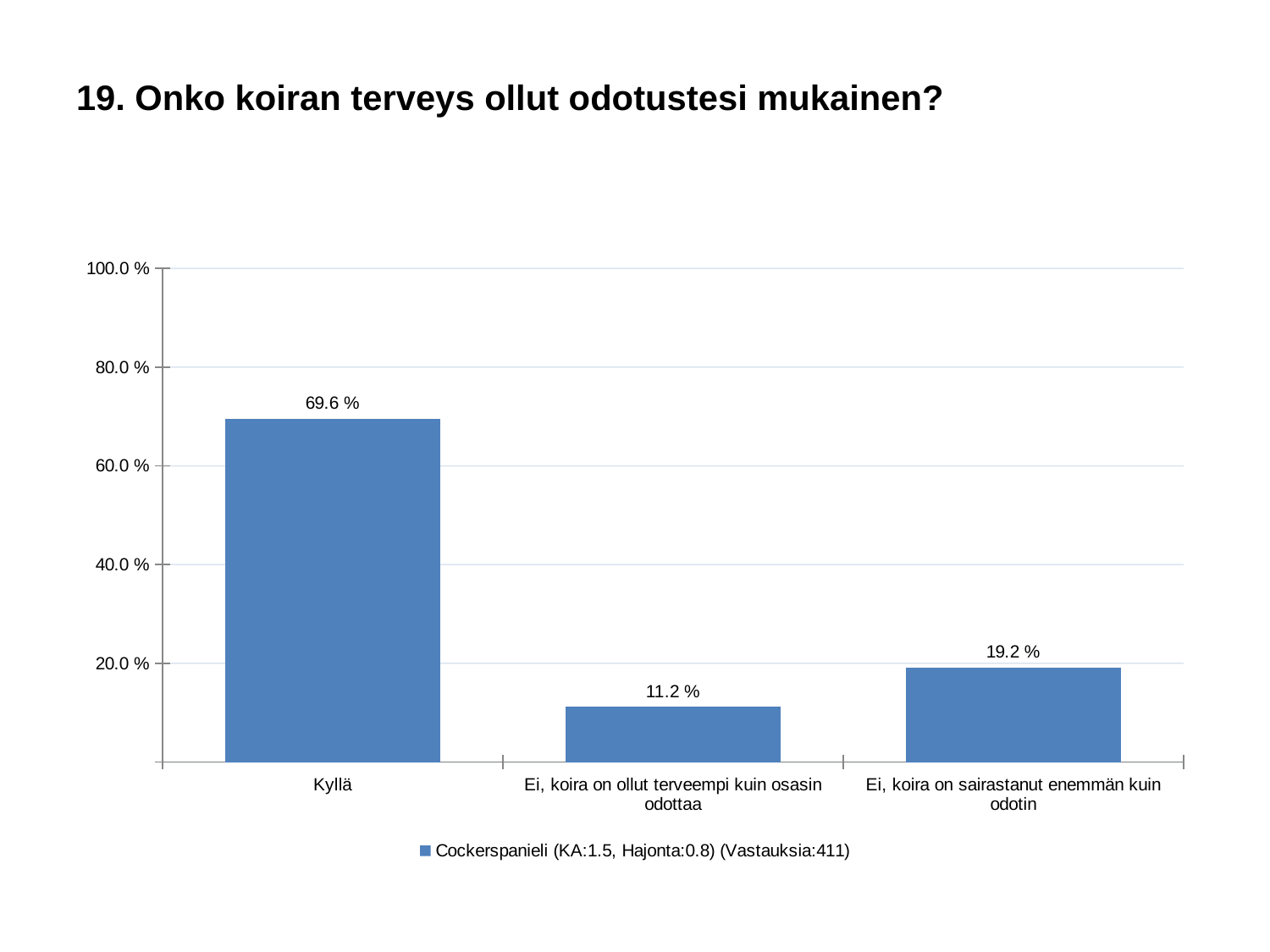
What is the value for "Kyllä"? 69.6 % What is the value for "Ei, koira on sairastanut enemmän kuin odotin"? 19.2 % Which is larger: the value for "Ei, koira on sairastanut enemmän kuin odotin" or the value for "Ei, koira on ollut terveempi kuin osasin odottaa"? Ei, koira on sairastanut enemmän kuin odotin Is the value for "Kyllä" greater or less than 60.0 %? greater How many categories are shown on the x axis? 3 What is the difference between the values for "Ei, koira on sairastanut enemmän kuin odotin" and "Ei, koira on ollut terveempi kuin osasin odottaa"? 8.0 % Which category has the highest value? Kyllä What kind of chart is shown on the slide? bar chart What is the difference between the values for "Kyllä" and "Ei, koira on sairastanut enemmän kuin odotin"? 50.4 % How many series does the legend list? 1 What is the value for "Ei, koira on ollut terveempi kuin osasin odottaa"? 11.2 % Which category has the lowest value? Ei, koira on ollut terveempi kuin osasin odottaa